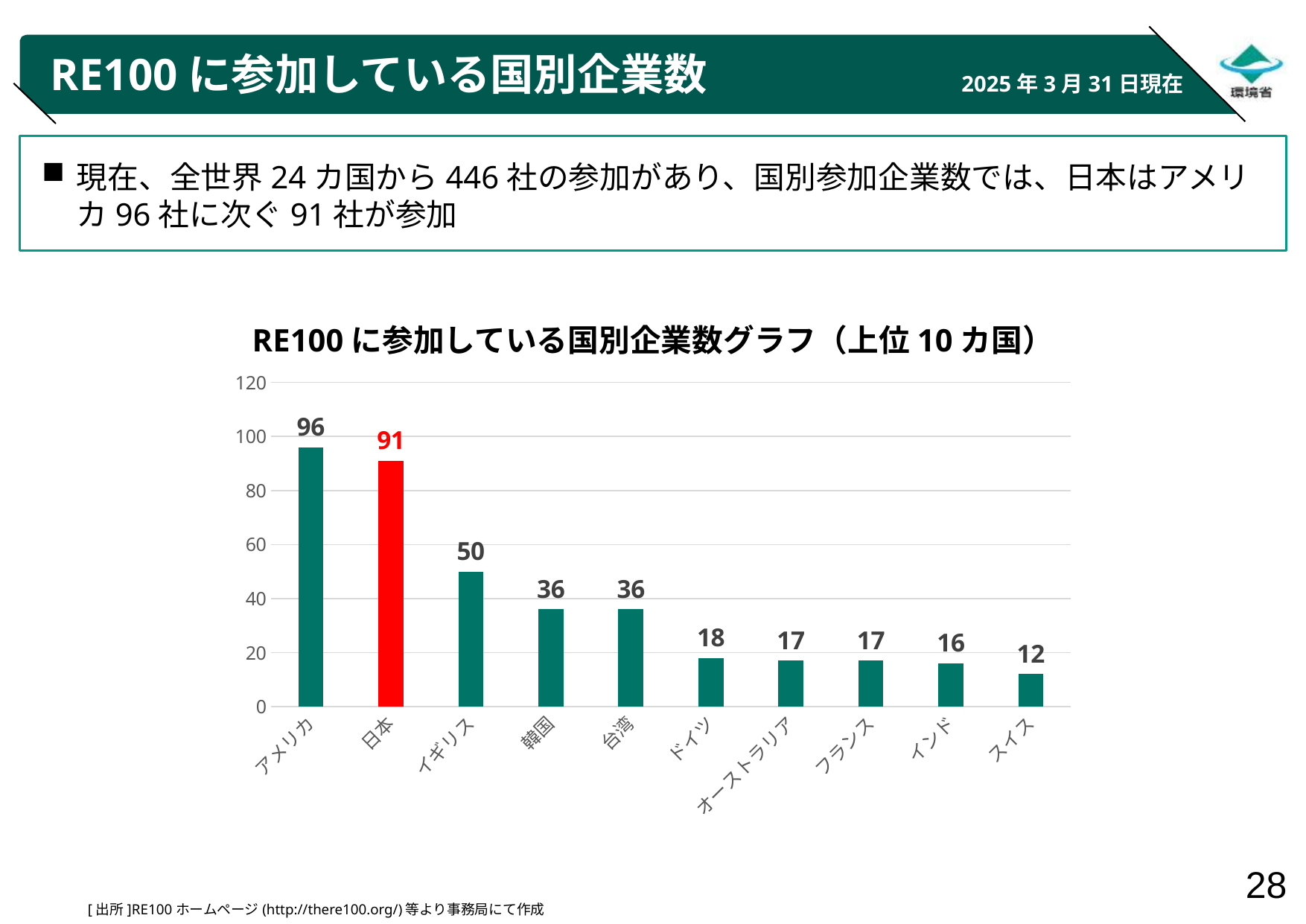
Which bar in the chart is coloured red? 日本 How many countries are shown in the chart? 10 What is the difference between the values for アメリカ and 日本? 5 What is the value for イギリス in the chart? 50 Which is larger, the value for 韓国 or the value for インド? 韓国 Do the values rise or fall from left to right along the x axis? Fall Which country has the highest value in the chart? アメリカ What is the difference between the values for イギリス and ドイツ? 32 What is the value for 日本 in the chart? 91 What is the value for スイス in the chart? 12 What kind of chart is shown on the slide? Bar chart Which country has the lowest value in the chart? スイス